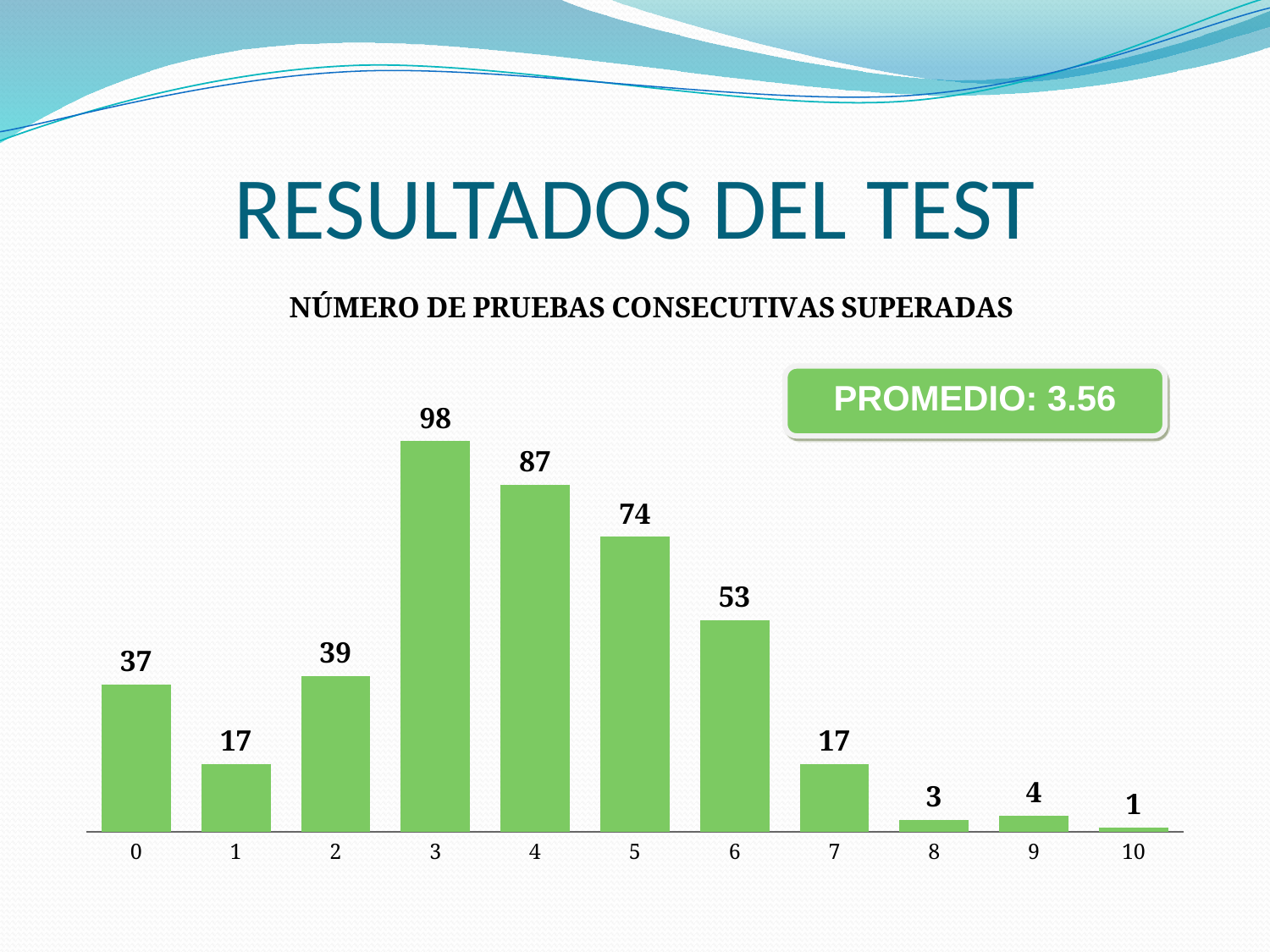
What is the difference between the values for categories 3 and 4? 11 What is the value for category 6? 53 What is the value for category 0? 37 Do the values rise or fall from category 3 to category 10? fall What kind of chart is shown on the slide? bar chart How many categories are shown on the x axis? 11 Which is larger, the value for category 2 or the value for category 0? 2 Which category has the highest value? 3 What is the difference between the values for categories 5 and 6? 21 What is the value for category 3? 98 What is the title of the chart? NÚMERO DE PRUEBAS CONSECUTIVAS SUPERADAS Which category has the lowest value? 10